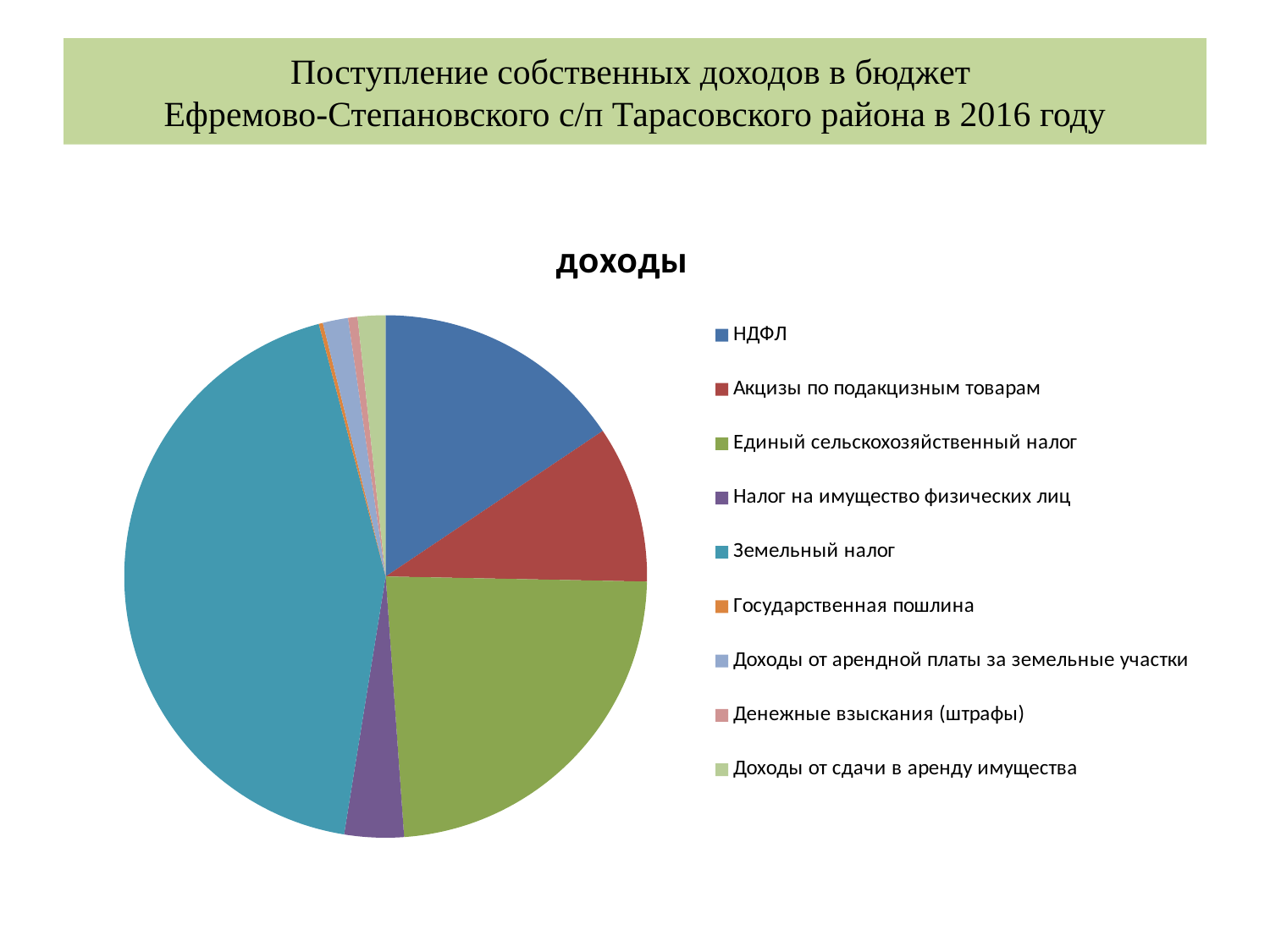
Which category is shown in the legend with the orange colour? Государственная пошлина What is the title of the pie chart? доходы What kind of chart is shown on the slide? pie chart How many categories (slices) does the pie chart "доходы" have? 9 Which slice is larger in the pie chart: Налог на имущество физических лиц or Государственная пошлина? Налог на имущество физических лиц Which category has the smallest slice in the pie chart "доходы"? Государственная пошлина Which slice is larger in the pie chart: Акцизы по подакцизным товарам or Налог на имущество физических лиц? Акцизы по подакцизным товарам Which slice is larger in the pie chart: НДФЛ or Акцизы по подакцизным товарам? НДФЛ Which category has the largest slice in the pie chart "доходы"? Земельный налог